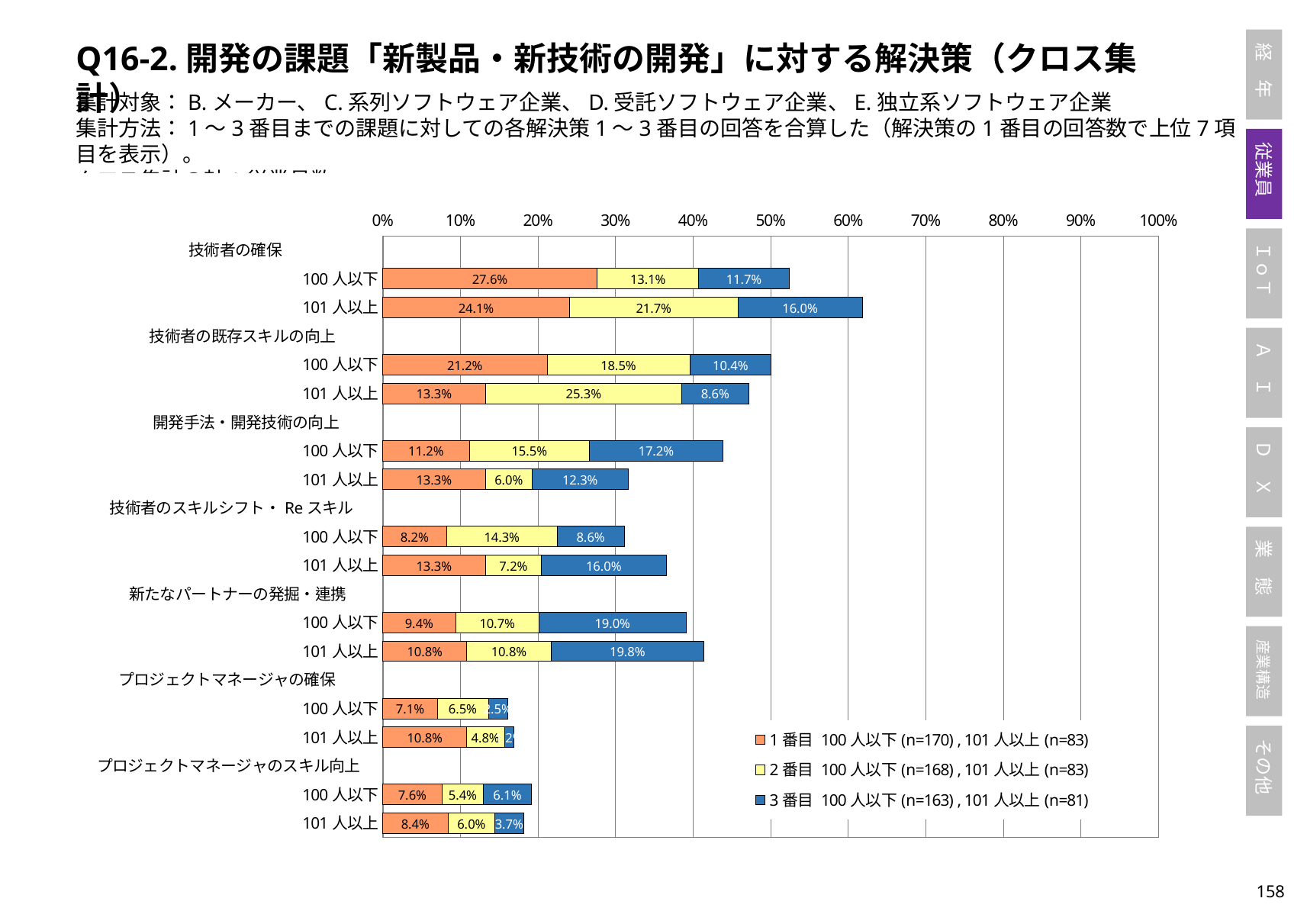
What is the n value for 100人以下 in the 1番目 legend entry? n=170 What is the 2番目 value for 技術者の既存スキルの向上 among 101人以上 companies? 25.3% How many solution categories (excluding the company-size sub-rows) are shown on the chart? 7 What kind of chart is shown on the slide? Stacked bar chart Which is larger: the 3番目 value for 開発手法・開発技術の向上 among 100人以下 or among 101人以上? 100人以下 What is the difference between the 1番目 values for 技術者の確保 between 100人以下 (27.6%) and 101人以上 (24.1%)? 3.5% What is the total of the stacked bar for 技術者の確保, 101人以上? 61.8% Is the total stacked bar for 技術者の確保, 101人以上 greater or less than 60%? greater What is the 1番目 value for 技術者の確保 among 100人以下 companies? 27.6% How many series does the legend list? 3 What is the total of the stacked bar for 開発手法・開発技術の向上, 100人以下? 43.9% What is the 3番目 value for 新たなパートナーの発掘・連携 among 101人以上 companies? 19.8%